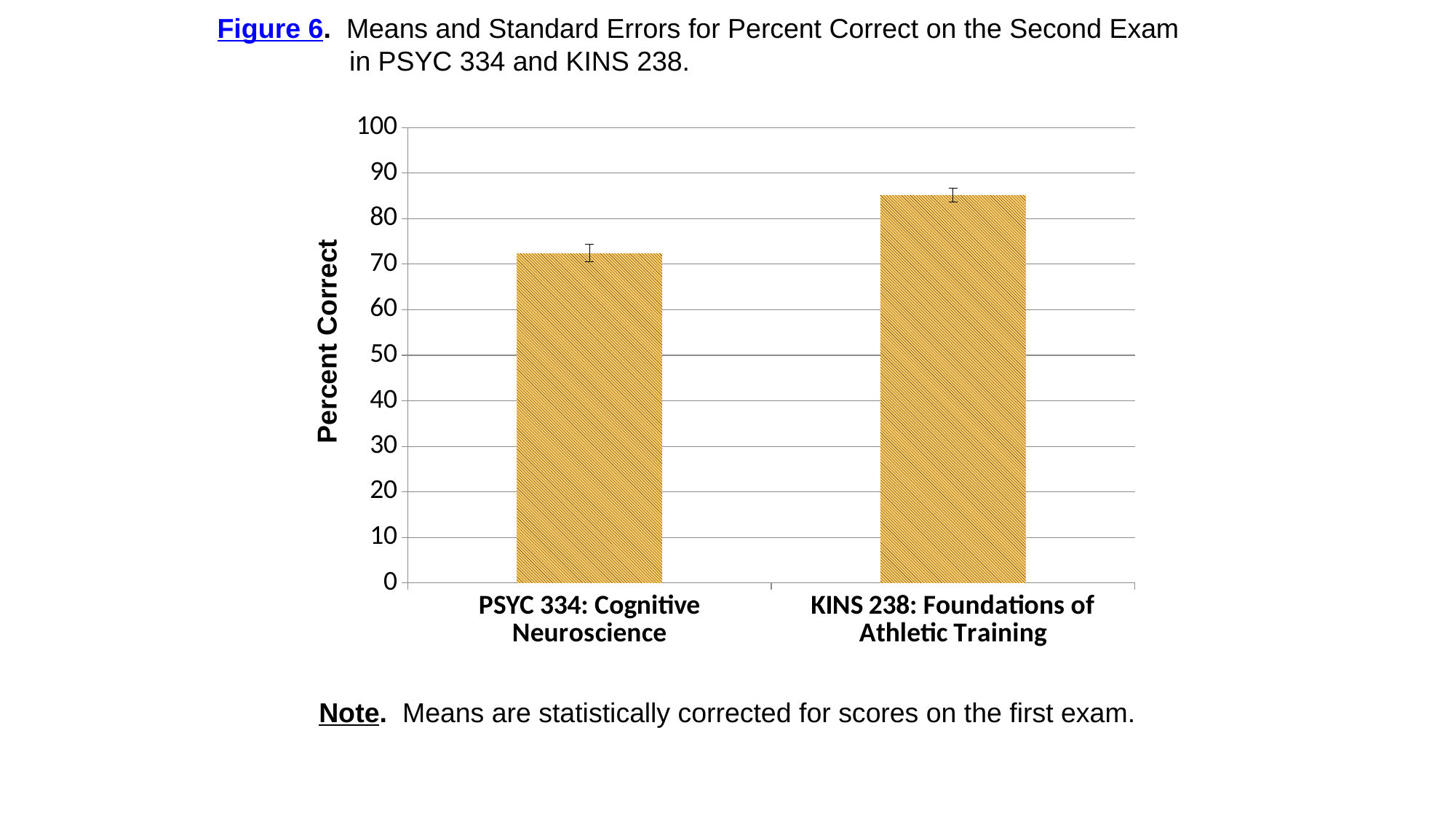
Which course has the lower percent correct on the second exam? PSYC 334: Cognitive Neuroscience How many categories (bars) are plotted in the chart? 2 What is the label on the vertical axis of the chart? Percent Correct Is the percent correct for PSYC 334: Cognitive Neuroscience greater or less than 80? less Is the percent correct for KINS 238: Foundations of Athletic Training greater or less than 90? less Is the percent correct for KINS 238: Foundations of Athletic Training greater or less than 80? greater Which is larger: the percent correct for PSYC 334: Cognitive Neuroscience or for KINS 238: Foundations of Athletic Training? KINS 238: Foundations of Athletic Training Which course has the higher percent correct on the second exam? KINS 238: Foundations of Athletic Training What is the maximum value shown on the vertical axis? 100 What kind of chart is shown on the slide? bar chart Do the bar values rise or fall from left to right across the x axis? rise